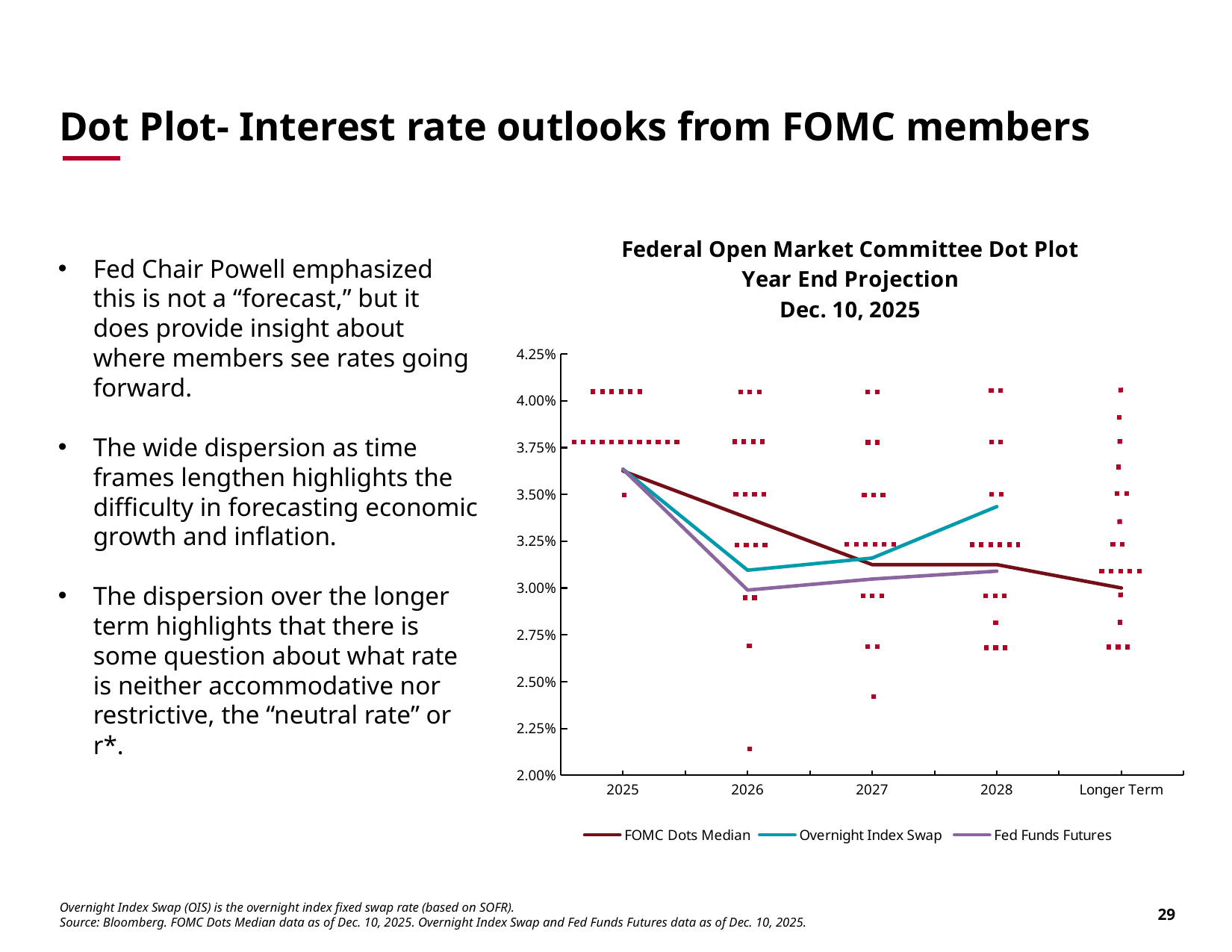
How many series does the legend list? 3 How many categories are shown on the x axis? 5 Is the Overnight Index Swap value for 2026 greater or less than 3.25%? less At 2028, which is higher: the Overnight Index Swap line or the FOMC Dots Median line? Overnight Index Swap Is the FOMC Dots Median value for 2025 greater or less than 3.50%? greater What is the title of the chart? Federal Open Market Committee Dot Plot Year End Projection Dec. 10, 2025 Does the FOMC Dots Median line rise or fall from 2025 to Longer Term? fall What are the three series listed in the legend? FOMC Dots Median, Overnight Index Swap, Fed Funds Futures Is the lowest individual dot for 2026 greater or less than 2.25%? less At which x-axis category is the FOMC Dots Median line highest? 2025 At 2026, which is higher: the FOMC Dots Median line or the Fed Funds Futures line? FOMC Dots Median